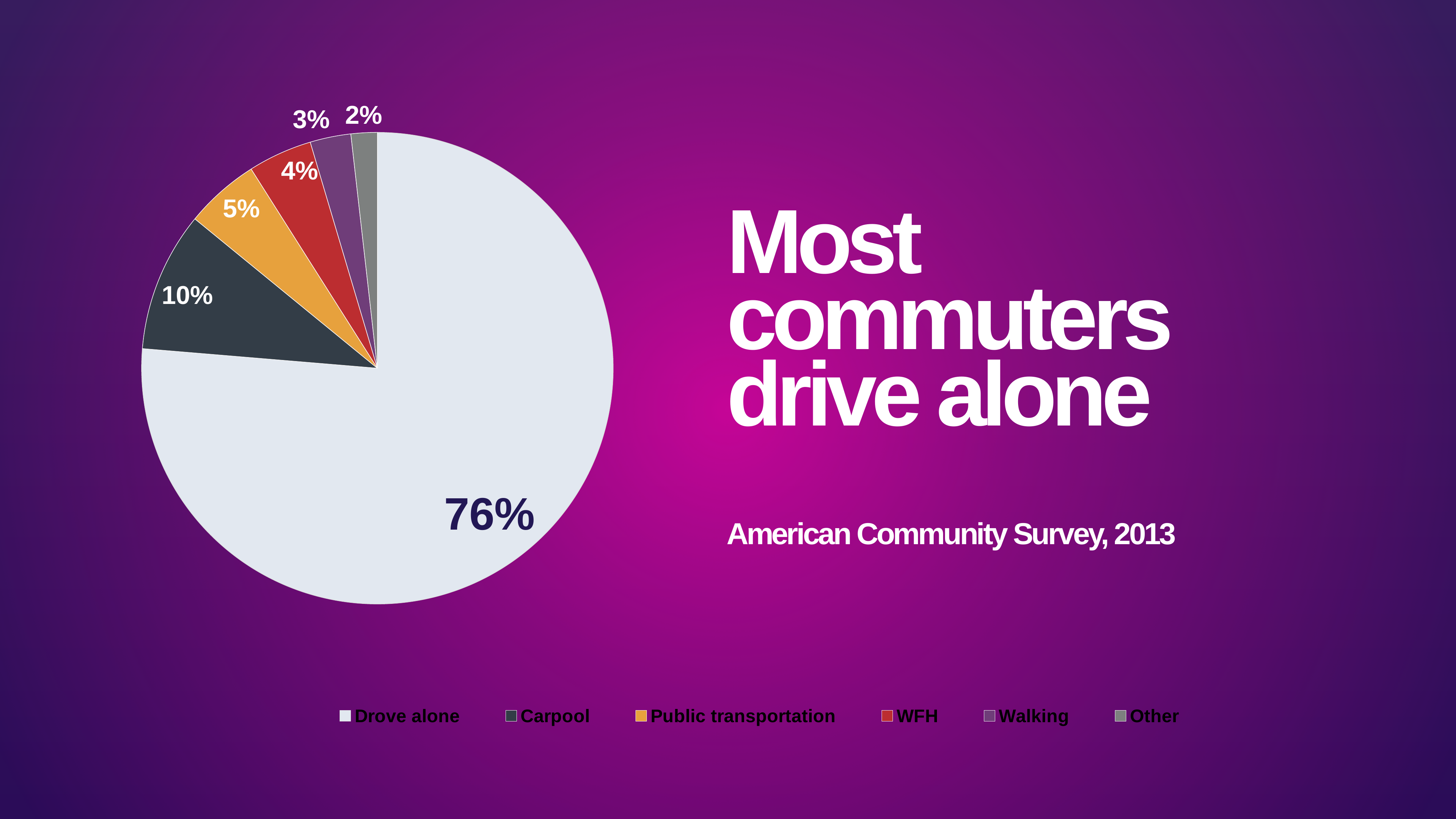
Which category has the largest slice of the pie? Drove alone Which category has the smallest slice of the pie? Other What is the value for WFH? 4% What share of commuters drove alone? 76% What is the difference between the Drove alone and Carpool shares? 66% Which is larger, the share for Public transportation or the share for WFH? Public transportation How many categories does the legend list? 6 What is the value for Public transportation? 5% What is the value for Walking? 3% What kind of chart is shown on the slide? Pie chart What percentage of commuters carpool? 10% What data source is cited on the slide? American Community Survey, 2013